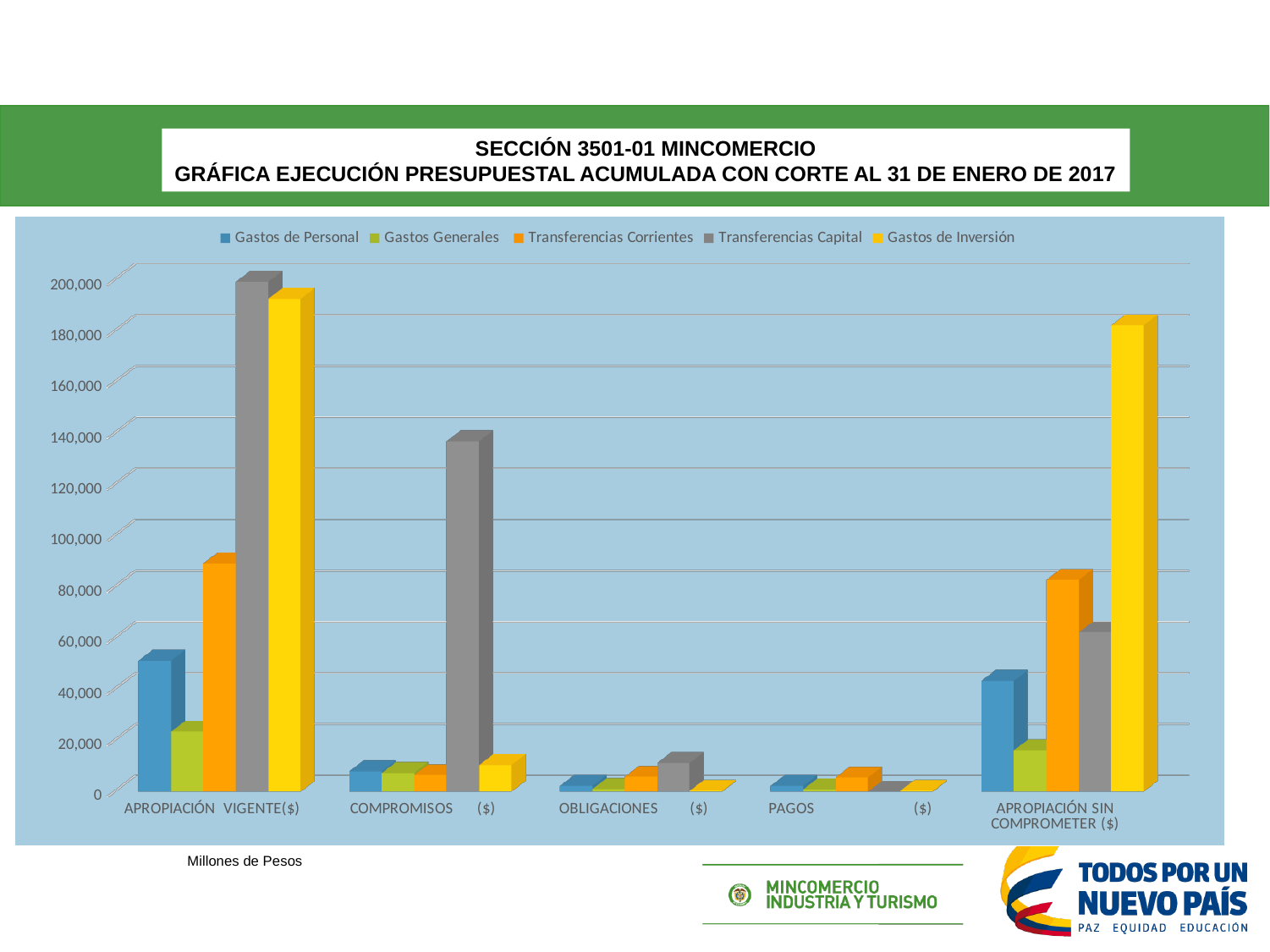
In the APROPIACIÓN VIGENTE category, which series has the lowest value? Gastos Generales In the APROPIACIÓN SIN COMPROMETER category, which is larger: Transferencias Corrientes or Transferencias Capital? Transferencias Corrientes Is the value for Transferencias Corrientes in the APROPIACIÓN VIGENTE category greater or less than 100,000? less How many series does the chart's legend list? 5 In the APROPIACIÓN SIN COMPROMETER category, which series has the highest value? Gastos de Inversión Is the value for Gastos de Inversión in the APROPIACIÓN SIN COMPROMETER category greater or less than 160,000? greater Is the value for Transferencias Capital in the COMPROMISOS category greater or less than 120,000? greater What unit is stated below the chart for the values? Millones de Pesos In the APROPIACIÓN VIGENTE category, which is larger: Gastos de Personal or Gastos Generales? Gastos de Personal In the COMPROMISOS category, which series has the highest value? Transferencias Capital How many categories are shown along the x axis of the chart? 5 What kind of chart is shown on the slide? bar chart